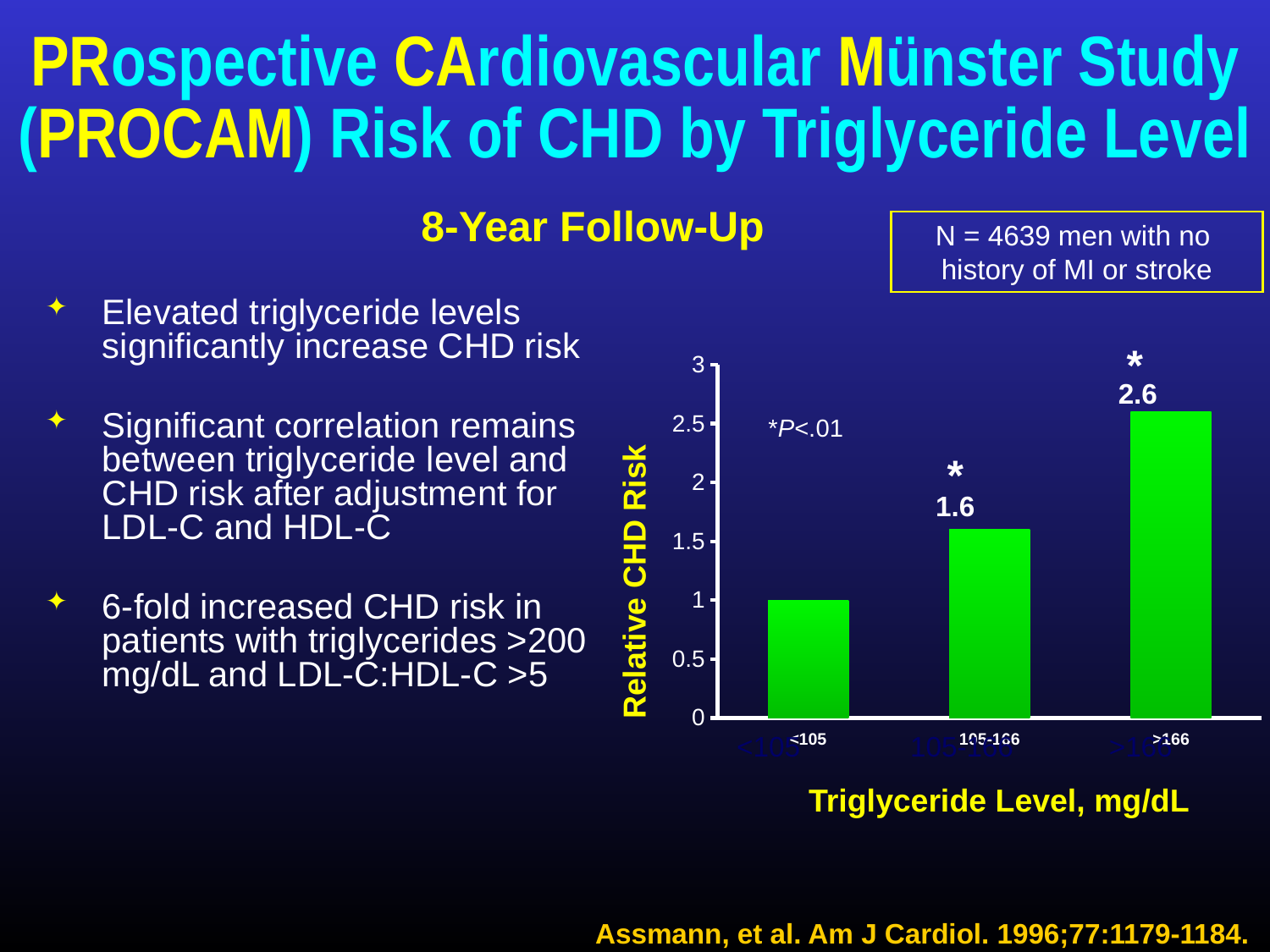
What is the relative CHD risk for the >166 mg/dL triglyceride group? 2.6 Which group has a larger relative CHD risk, 105-166 or >166? >166 What is the difference in relative CHD risk between the >166 and 105-166 triglyceride groups? 1 What is the relative CHD risk for the 105-166 mg/dL triglyceride group? 1.6 Which triglyceride level group has the lowest relative CHD risk? <105 How many triglyceride level categories are shown in the chart? 3 Is the relative CHD risk for the >166 group greater or less than 2? greater Does relative CHD risk rise or fall as triglyceride level increases along the x axis? rise Is the relative CHD risk for the <105 group greater or less than 1.5? less What kind of chart is used to show relative CHD risk by triglyceride level? bar chart What is the label of the y axis of the chart? Relative CHD Risk Which triglyceride level group has the highest relative CHD risk? >166